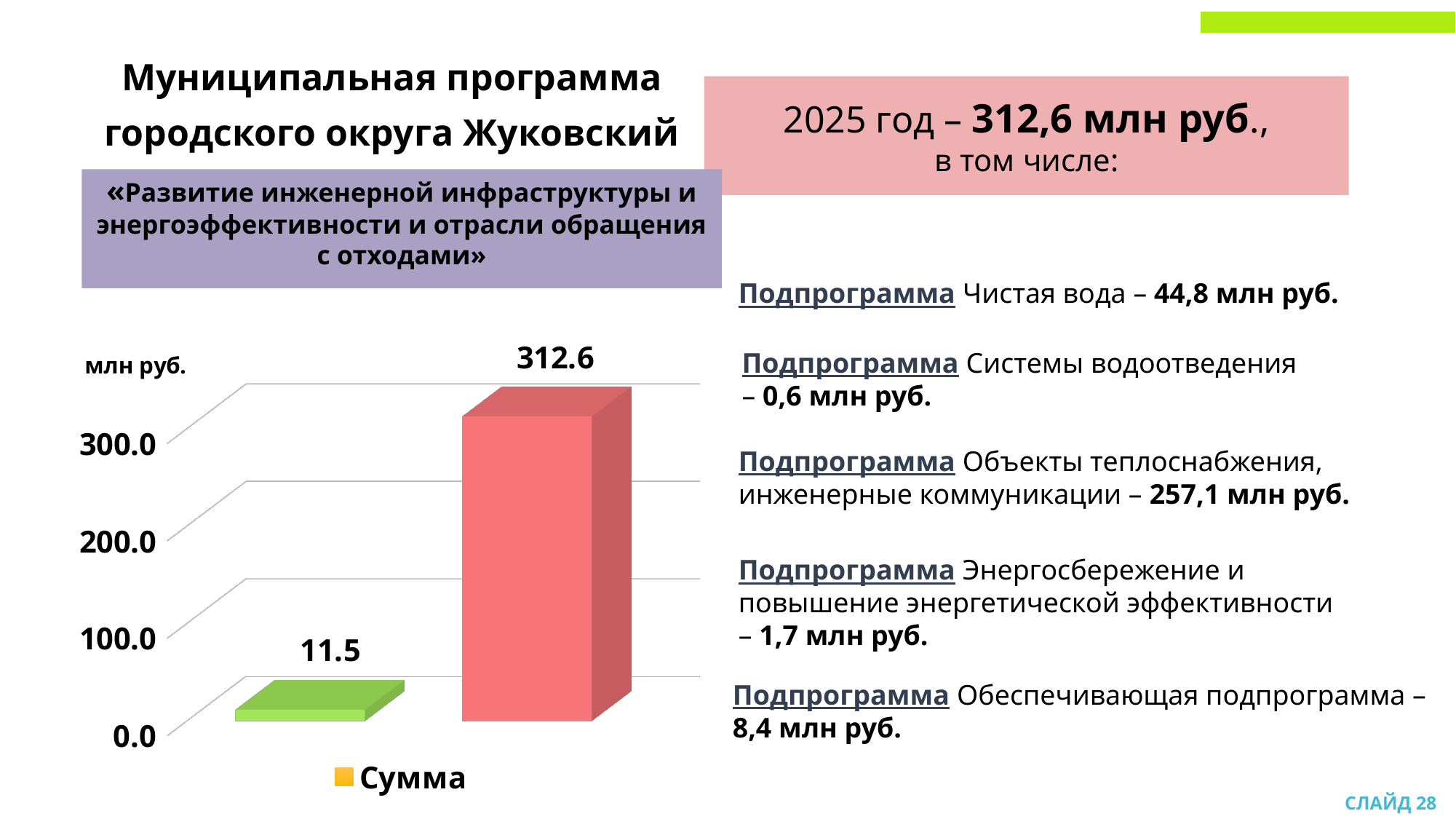
Is the value of the red bar greater or less than 300.0? greater How many bars are plotted in the chart? 2 Is the value of the green bar greater or less than 100.0? less What is the value shown on the red bar in the chart? 312.6 Which bar has the highest value in the chart? the red bar (312.6) Which bar has the lowest value in the chart? the green bar (11.5) What unit is shown on the vertical axis of the chart? млн руб. Which is larger, the value of the green bar or the value of the red bar? the red bar How many series does the chart legend list? 1 What type of chart is shown on the slide? bar chart What is the difference between the red bar value and the green bar value? 301.1 What is the value shown on the green bar in the chart? 11.5